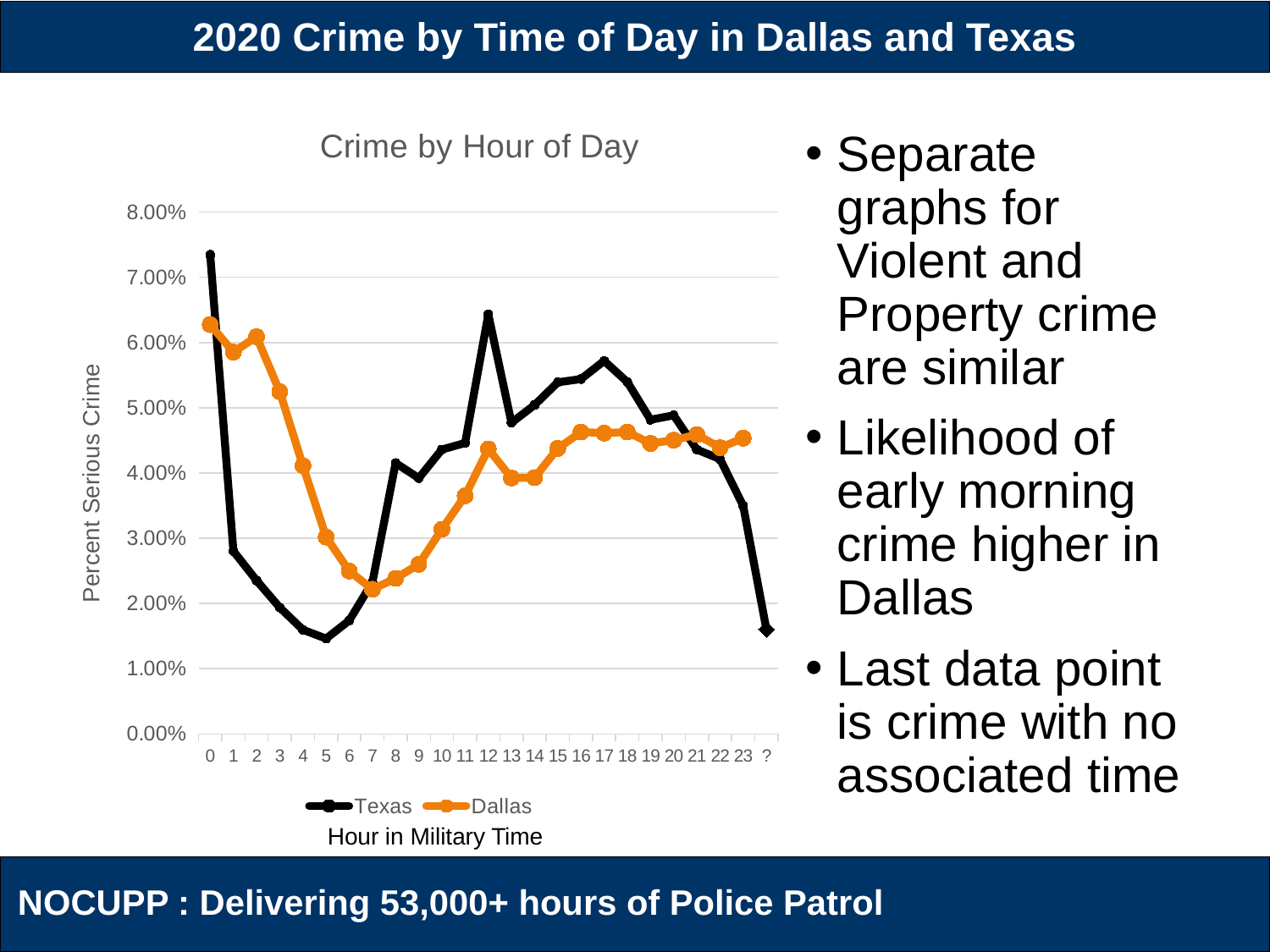
Is the Dallas value at hour 5 greater or less than 4.00%? less At hour 2, which series has the higher value, Texas or Dallas? Dallas What are the two series named in the legend of the "Crime by Hour of Day" chart? Texas and Dallas Does the Texas series rise or fall from hour 0 to hour 5? fall Is the Texas value at hour 12 greater or less than 6.00%? greater At which hour is the Dallas series lowest in the "Crime by Hour of Day" chart? 7 At which hour is the Texas series highest in the "Crime by Hour of Day" chart? 0 At which hour is the Texas series lowest in the "Crime by Hour of Day" chart? 5 What kind of chart is "Crime by Hour of Day"? line chart What is the title of the vertical axis in the "Crime by Hour of Day" chart? Percent Serious Crime At which hour is the Dallas series highest in the "Crime by Hour of Day" chart? 0 How many series does the legend of the "Crime by Hour of Day" chart list? 2